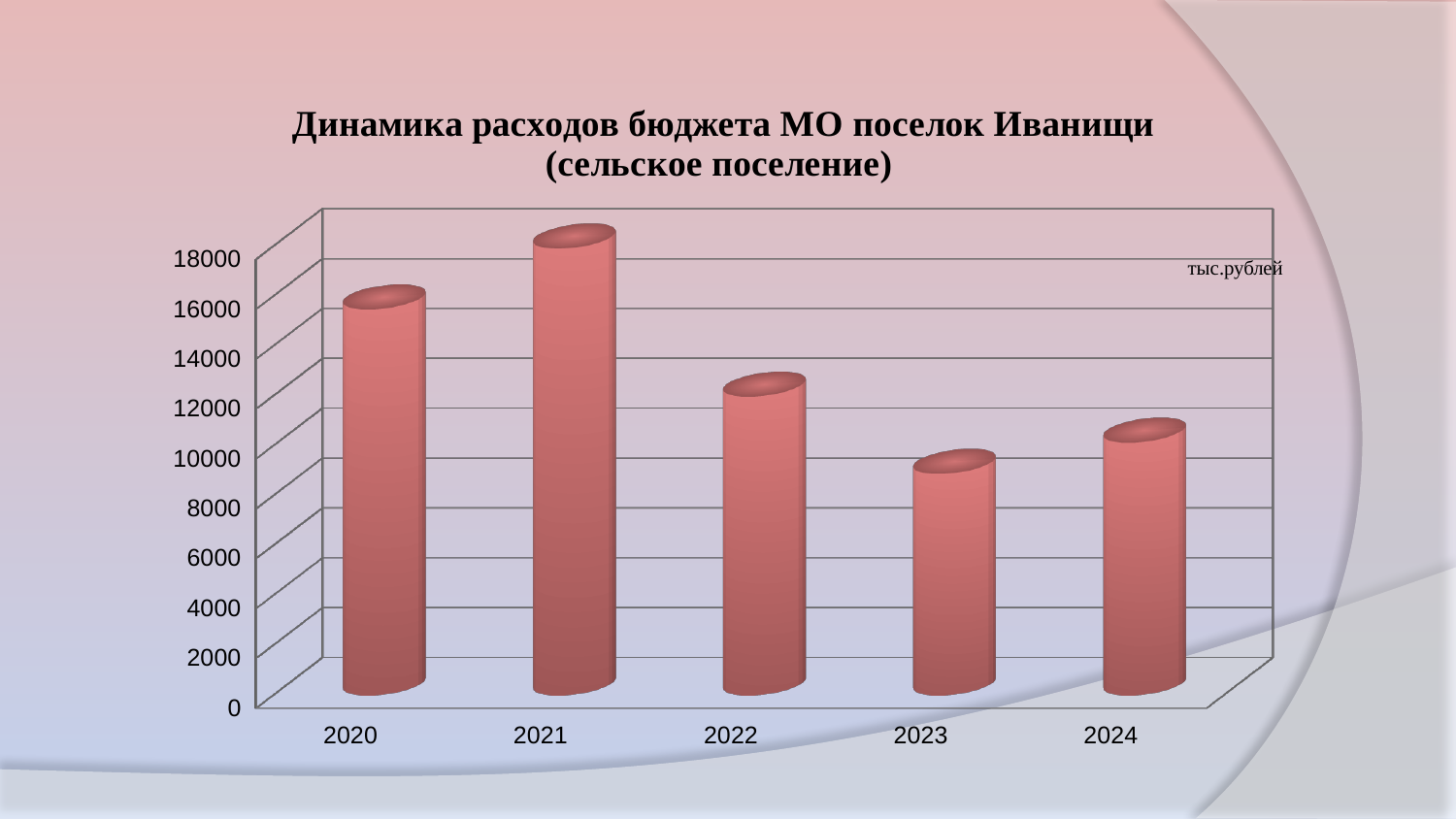
Is the value for 2021 greater or less than 16000? greater Do the values rise or fall from 2021 to 2023? fall Which year has the highest budget expenditure in the chart? 2021 Is the value for 2022 greater or less than 14000? less Which year has the lowest budget expenditure in the chart? 2023 Which year has the larger value, 2023 or 2024? 2024 How many years are shown on the x axis of the chart? 5 Is the value for 2023 greater or less than 12000? less Which year has the larger value, 2020 or 2022? 2020 What type of chart is shown on the slide? bar chart What unit of measurement is indicated on the chart? тыс.рублей